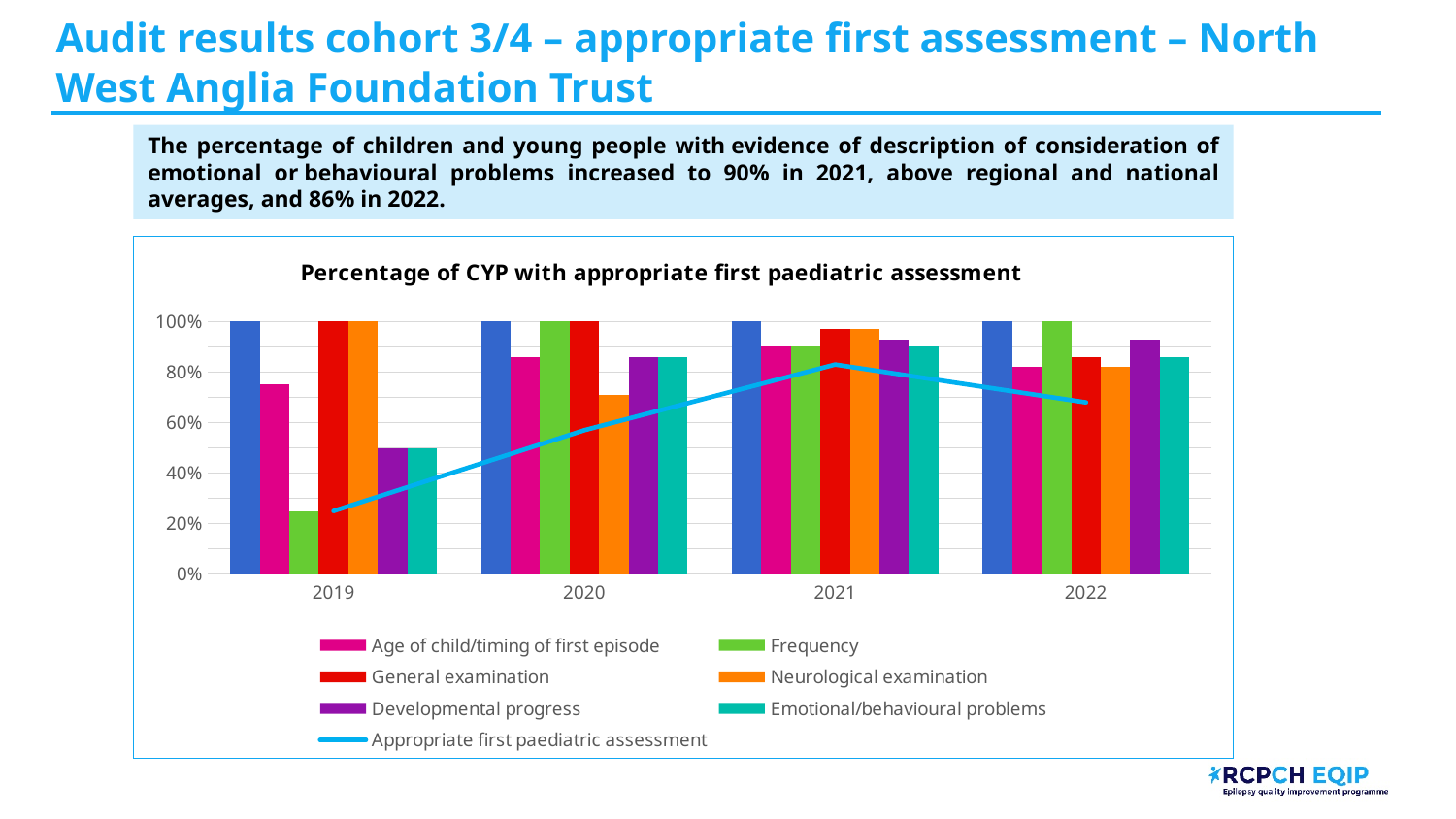
What is the title of the chart? Percentage of CYP with appropriate first paediatric assessment How many years are shown on the x axis of the chart? 4 Is the Appropriate first paediatric assessment line value in 2021 greater or less than 60%? greater What kind of chart is this? Bar chart with a line Is the value for Developmental progress in 2019 greater or less than 60%? less Which year has the lowest value for Frequency? 2019 Is the value for Frequency in 2019 greater or less than 40%? less Which is larger: Neurological examination in 2020 or Neurological examination in 2021? 2021 How many series does the chart legend list? 7 Does the Appropriate first paediatric assessment line rise or fall from 2019 to 2021? rise Does the Appropriate first paediatric assessment line rise or fall from 2021 to 2022? fall